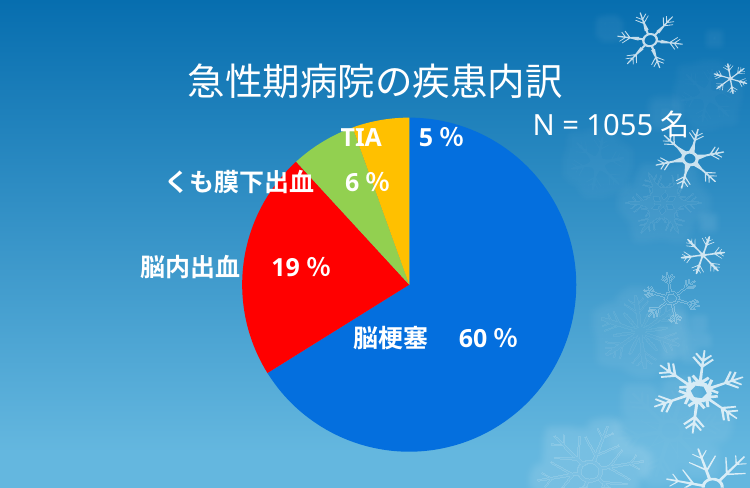
What is the difference in percentage points between 脳梗塞 and 脳内出血? 41 What is the sample size (N) stated on the slide? 1055 名 What percentage does くも膜下出血 account for? 6 % Which category has the largest share of the pie? 脳梗塞 What percentage does TIA account for? 5 % How many categories are shown in the pie chart? 4 Which category has the smallest share of the pie? TIA What is the title of the chart? 急性期病院の疾患内訳 What percentage does 脳梗塞 account for? 60 % What kind of chart is shown on the slide? pie chart What percentage does 脳内出血 account for? 19 % Which is larger, the share for くも膜下出血 or the share for TIA? くも膜下出血